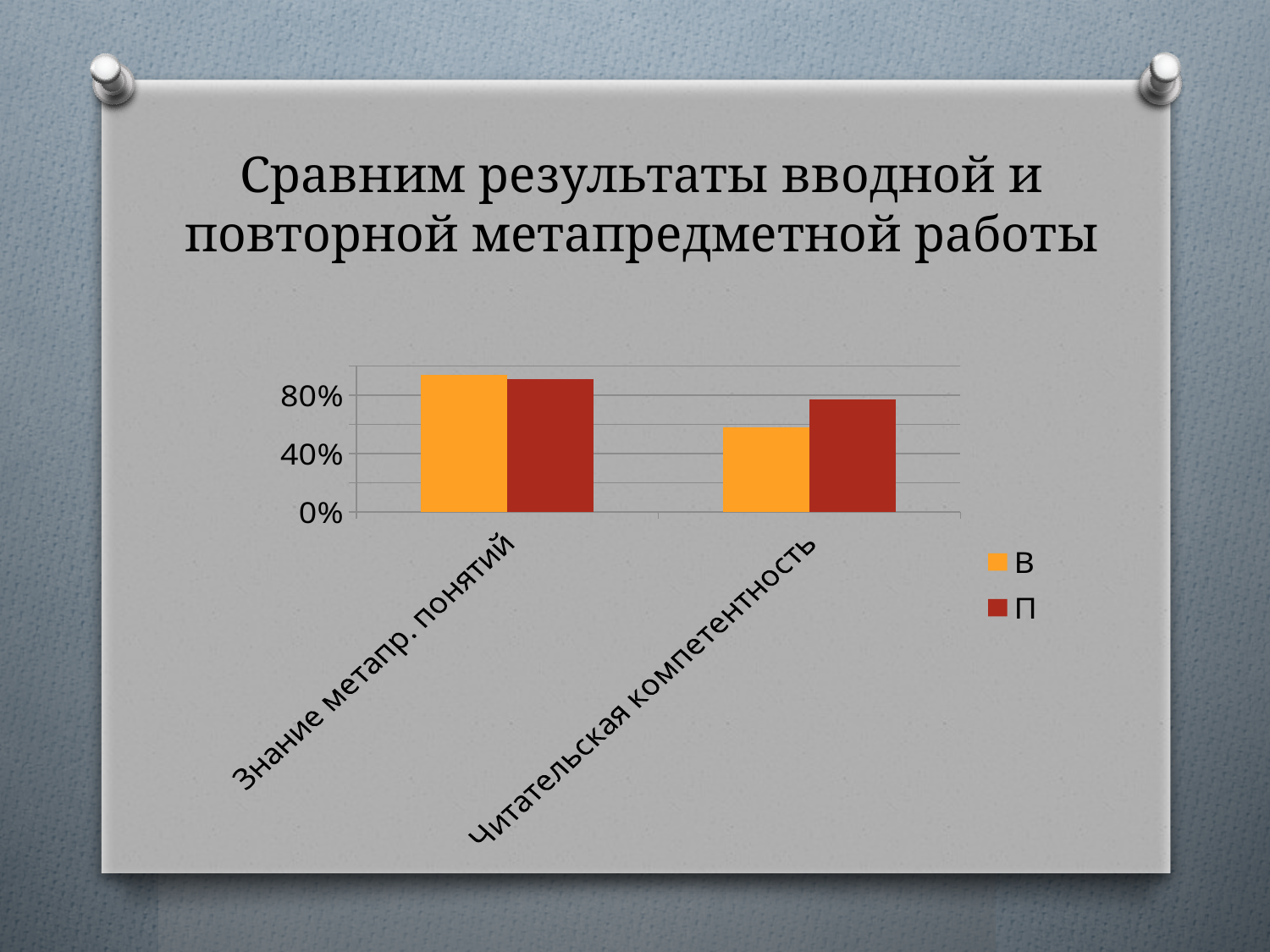
Is the value of series В for Читательская компетентность greater or less than 40%? greater What is the title of the slide containing the chart? Сравним результаты вводной и повторной метапредметной работы How many categories are shown on the x axis of the chart? 2 Is the value of series П for Читательская компетентность greater or less than 40%? greater How many series does the chart's legend list? 2 Is the value of series В for Знание метапр. понятий greater or less than 80%? greater For Читательская компетентность, which series has the larger value, В or П? П What kind of chart is shown on the slide? bar chart For series В, which category has the highest value? Знание метапр. понятий What are the two series named in the legend? В and П